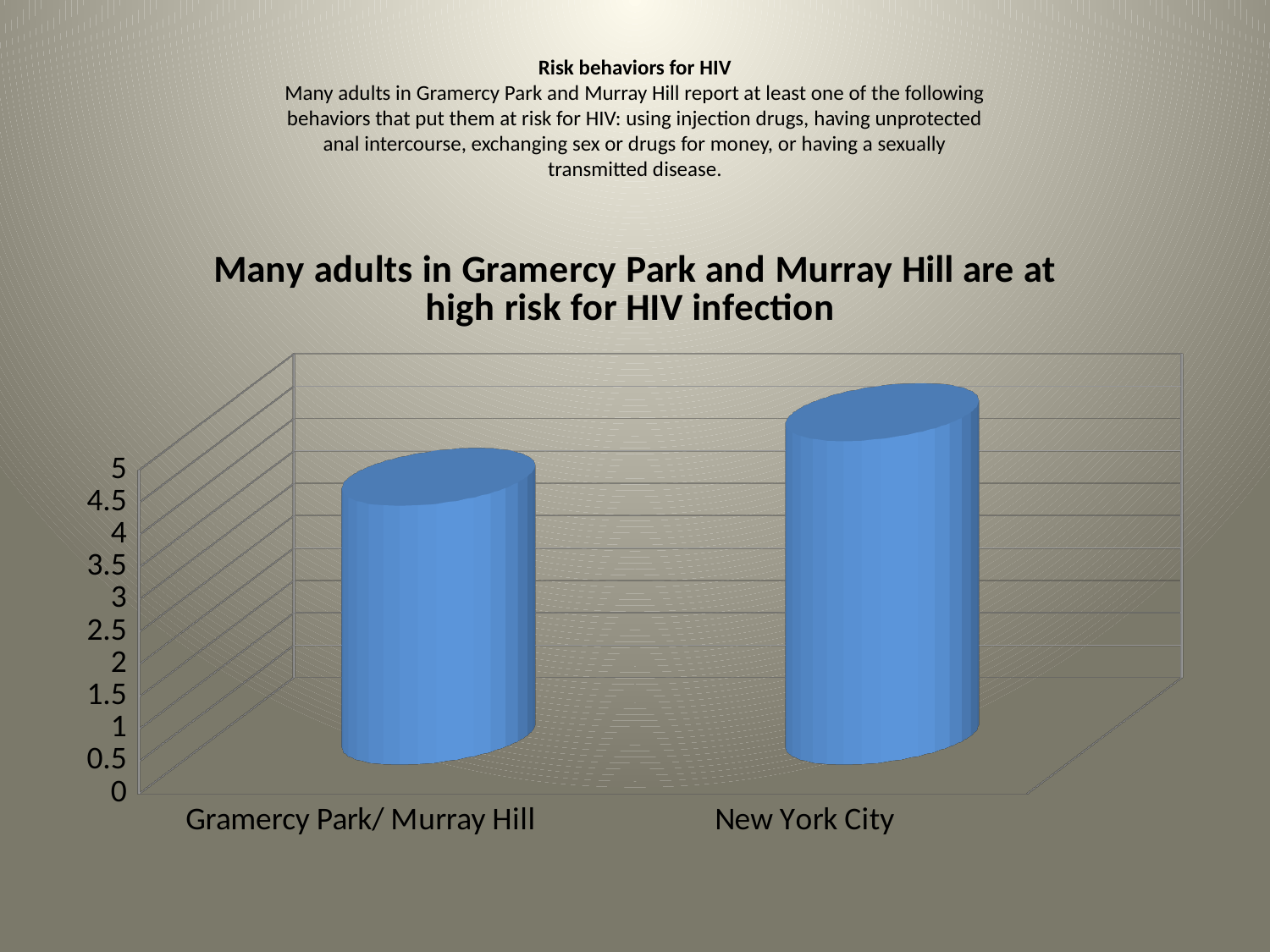
Which category has the lowest value on the chart? Gramercy Park/ Murray Hill Is the value for Gramercy Park/ Murray Hill greater or less than 2? greater Is the value for New York City greater or less than 3? greater What is the title of the chart? Many adults in Gramercy Park and Murray Hill are at high risk for HIV infection Which category has the higher bar, Gramercy Park/ Murray Hill or New York City? New York City How many categories are plotted on the chart? 2 What kind of chart is shown on the slide? bar chart Which category has the highest value on the chart? New York City Is the value for Gramercy Park/ Murray Hill greater or less than 5? less What is the highest value shown on the chart's vertical axis? 5